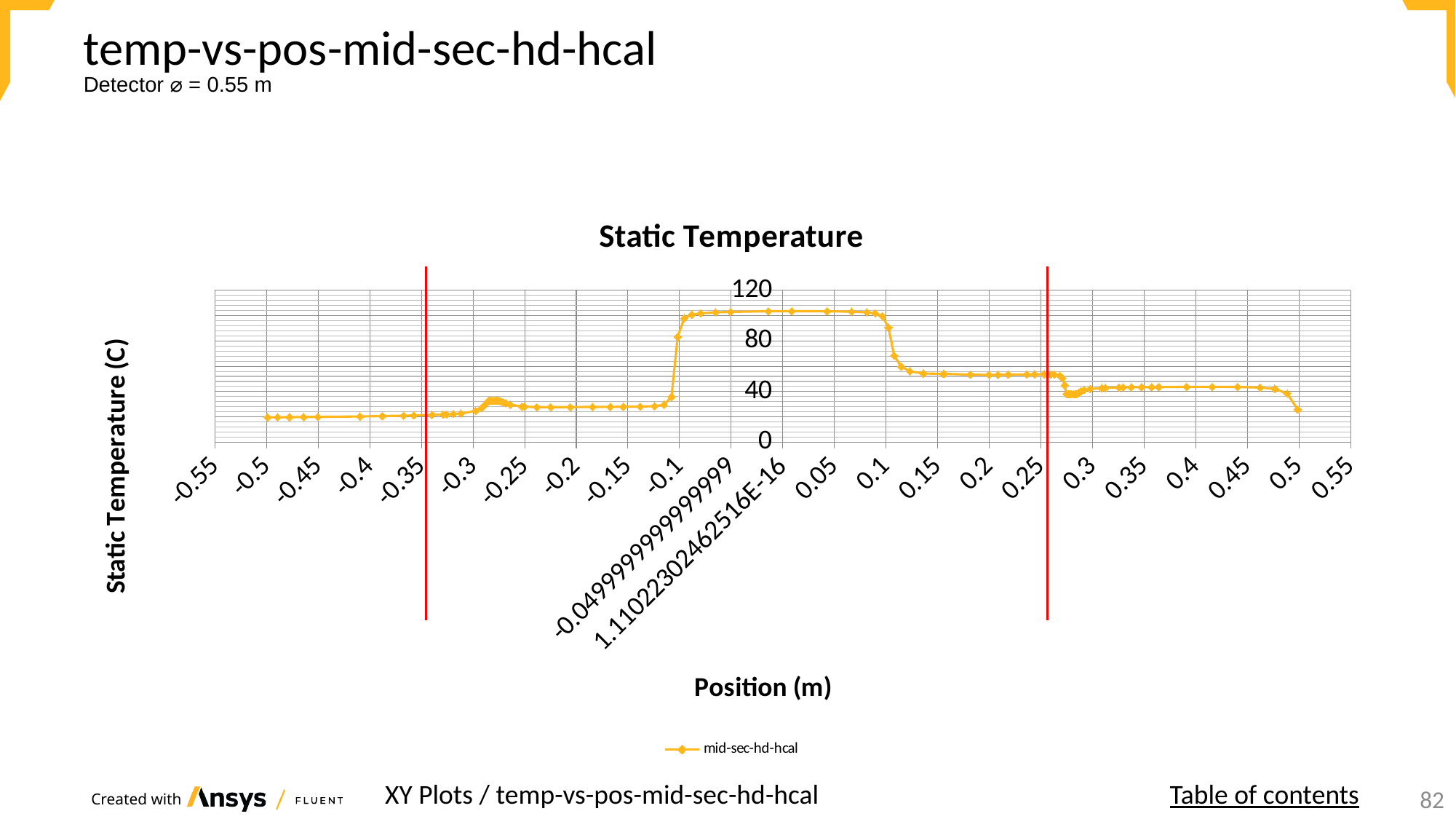
Is the value for position 0.05 greater or less than 80? greater What kind of chart is shown on the slide? line chart How many series does the legend list? 1 What is the title of the chart? Static Temperature Which has the larger value, position 0 or position -0.5? 0 Do the values rise or fall along the x axis between position 0.1 and position 0.15? fall Which has the larger value, position -0.3 or position 0.3? 0.3 What is the label of the x axis? Position (m) Is the value for position 0.2 greater or less than 40? greater Is the value for position -0.2 greater or less than 40? less